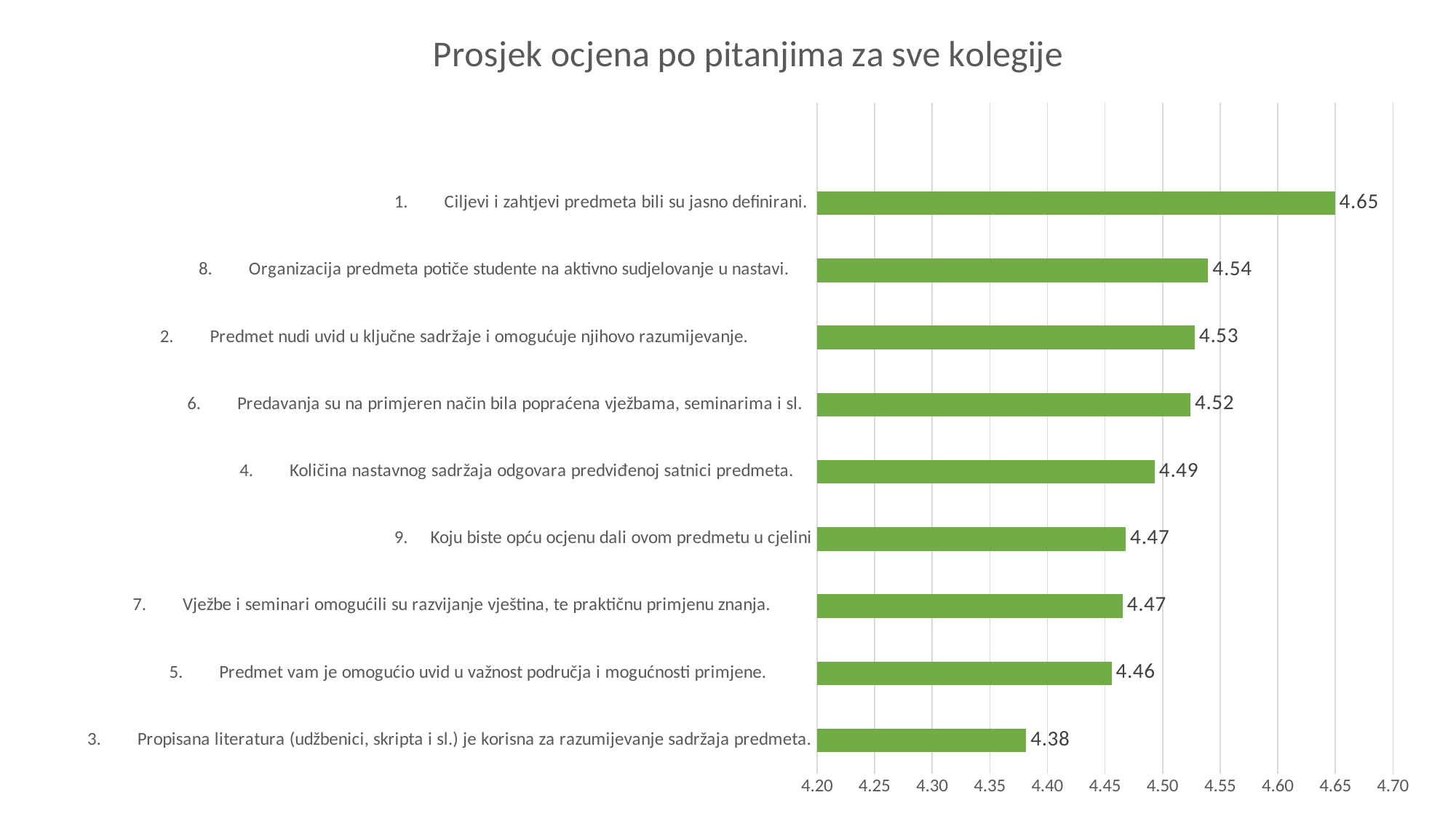
What is the value for "Propisana literatura (udžbenici, skripta i sl.) je korisna za razumijevanje sadržaja predmeta."? 4.38 What is the value for "Ciljevi i zahtjevi predmeta bili su jasno definirani."? 4.65 What type of chart is shown on the slide? bar chart What is the difference between the highest value (4.65) and the lowest value (4.38)? 0.27 How many categories (bars) are shown in the chart? 9 What is the title of the chart? Prosjek ocjena po pitanjima za sve kolegije Which category has the highest value? Ciljevi i zahtjevi predmeta bili su jasno definirani. Is the value for "Predavanja su na primjeren način bila popraćena vježbama, seminarima i sl." greater or less than 4.50? greater What is the value for "Količina nastavnog sadržaja odgovara predviđenoj satnici predmeta."? 4.49 What is the value for "Organizacija predmeta potiče studente na aktivno sudjelovanje u nastavi."? 4.54 Which category has the lowest value? Propisana literatura (udžbenici, skripta i sl.) je korisna za razumijevanje sadržaja predmeta. Which is larger: the value for "Predmet nudi uvid u ključne sadržaje i omogućuje njihovo razumijevanje." or the value for "Predmet vam je omogućio uvid u važnost područja i mogućnosti primjene."? Predmet nudi uvid u ključne sadržaje i omogućuje njihovo razumijevanje.